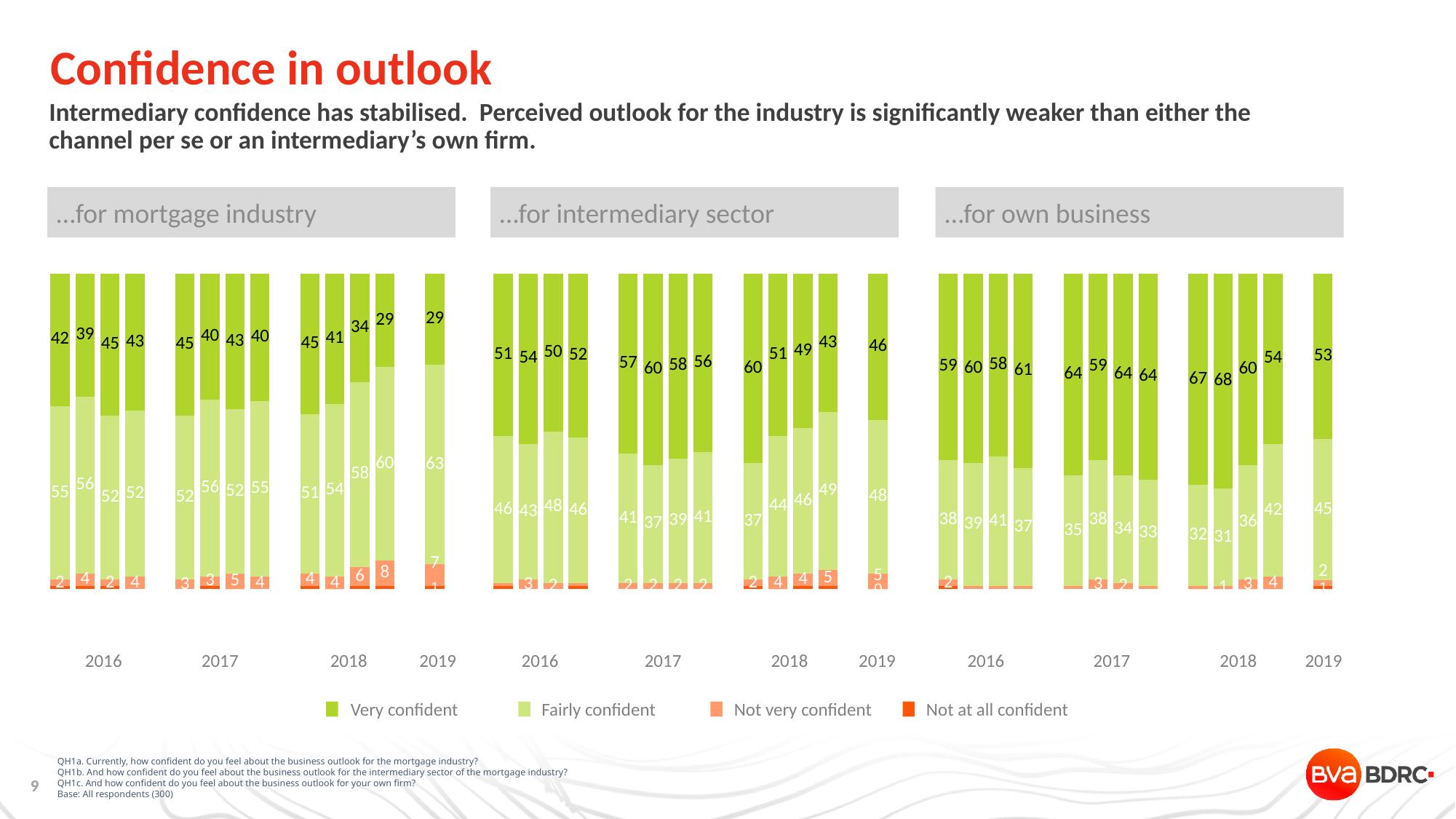
In the '...for mortgage industry' chart, do the Very confident values rise or fall across the four 2018 bars? Fall What kind of chart is used on this slide? Stacked bar chart For 2019, which chart shows the larger Very confident value: '...for own business' or '...for mortgage industry'? ...for own business In the '...for own business' chart, what is the Fairly confident value for 2019? 45 What is the difference between the 2019 Very confident value in the '...for own business' chart and the 2019 Very confident value in the '...for mortgage industry' chart? 24 In the '...for intermediary sector' chart, what is the lowest Very confident value shown? 43 In the '...for mortgage industry' chart, what is the Very confident value for 2019? 29 In the '...for own business' chart, what is the highest Very confident value shown? 68 What colour represents 'Not very confident' in the legend? Orange In the '...for intermediary sector' chart, what is the Very confident value for 2019? 46 In the '...for mortgage industry' chart, what is the total of the 2019 stacked bar? 100 How many series does the legend list? 4